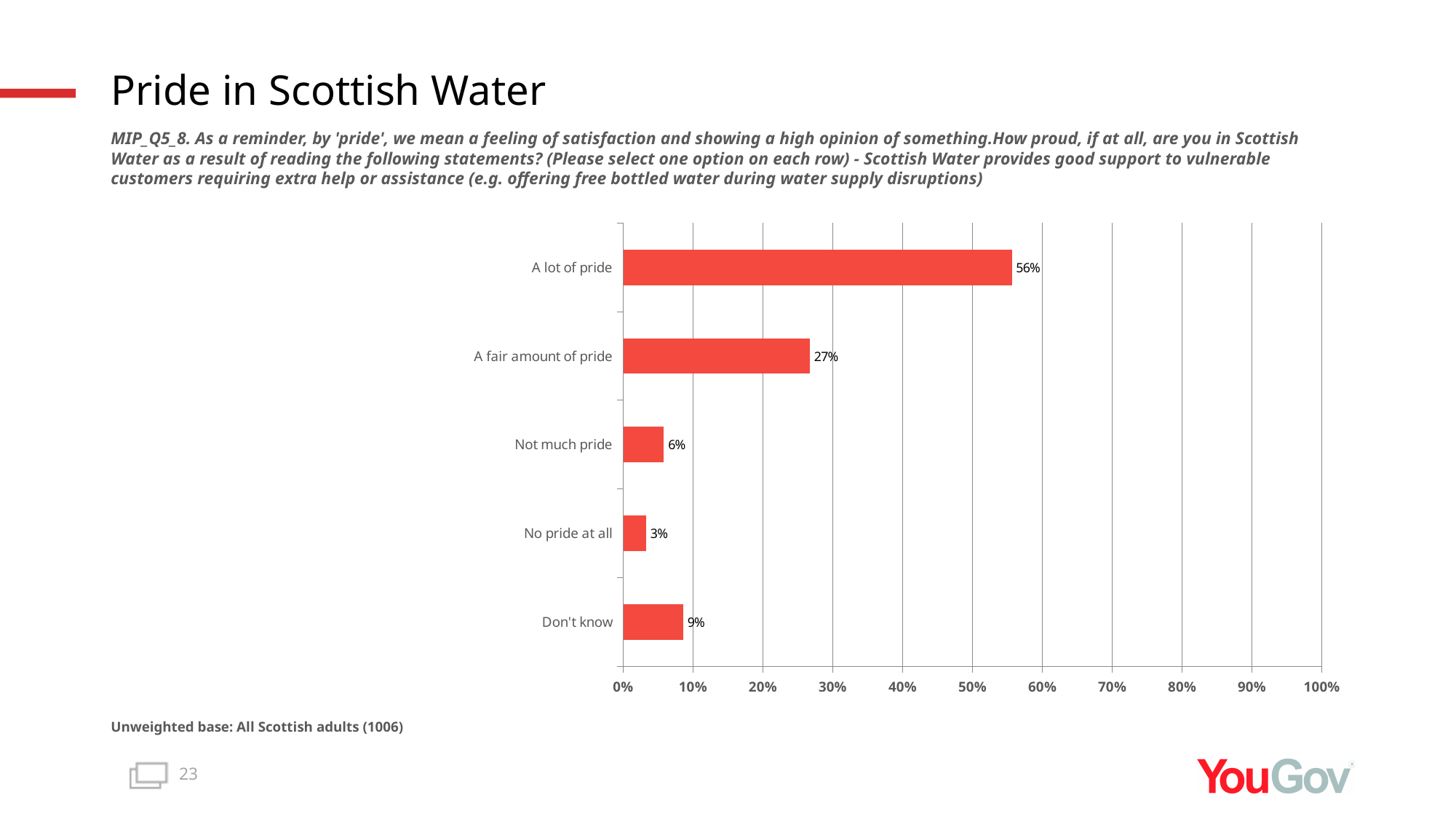
What is the value for 'No pride at all'? 3% Which category has the lowest value? No pride at all What percentage of respondents said they feel 'A lot of pride'? 56% What is the difference between 'A lot of pride' and 'A fair amount of pride'? 29 percentage points What is the title of the slide? Pride in Scottish Water How many categories are shown in the chart? 5 What percentage answered 'Don't know'? 9% Is the value for 'A lot of pride' greater or less than 50%? greater What is the value for 'A fair amount of pride'? 27% Which is larger, 'Not much pride' or 'Don't know'? Don't know Which category has the highest value? A lot of pride What type of chart is shown on the slide? Bar chart